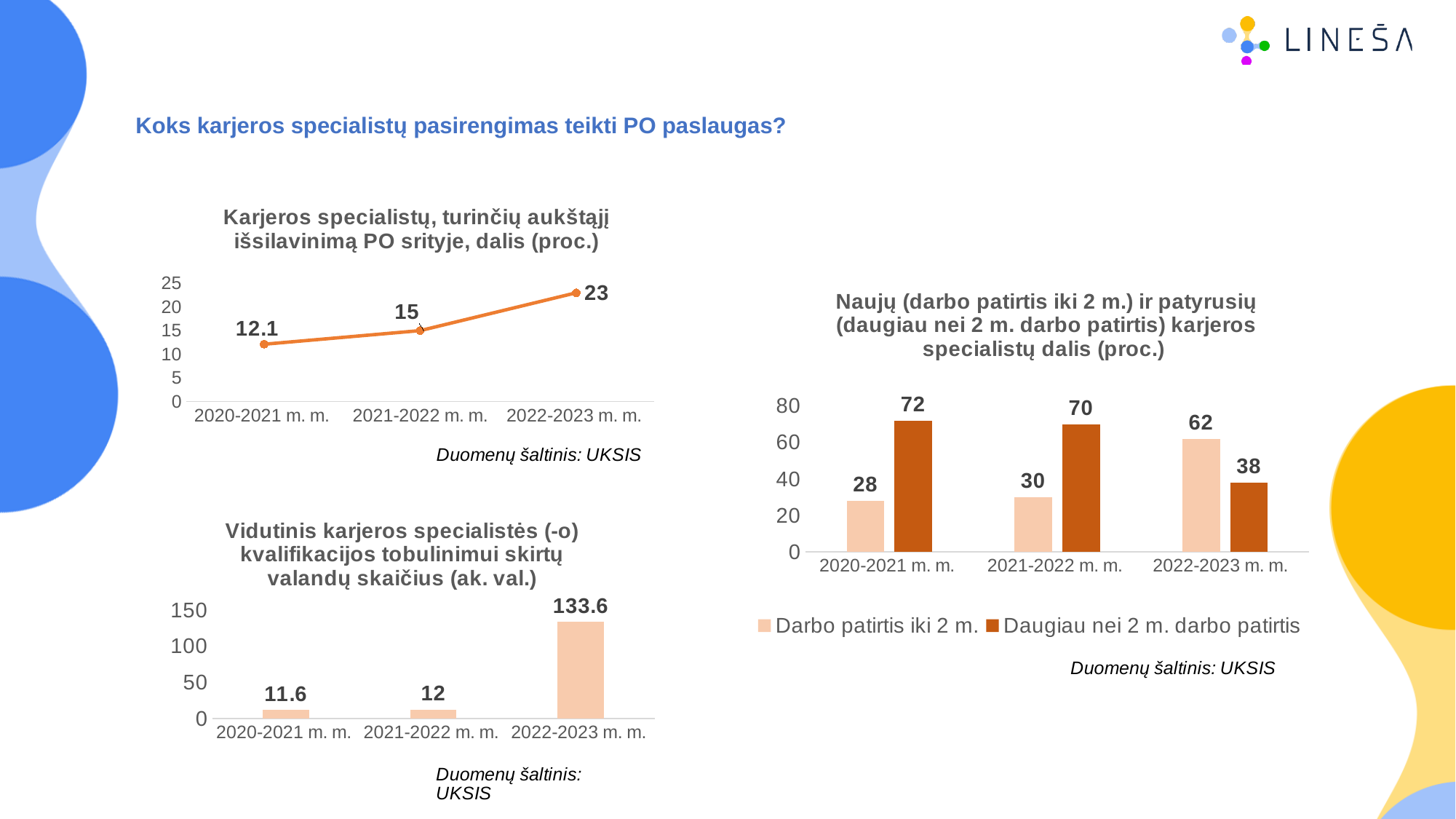
In the bottom-left bar chart (Vidutinis karjeros specialistės (-o) kvalifikacijos tobulinimui skirtų valandų skaičius), which school year has the lowest value? 2020-2021 m. m. In the right-hand bar chart (Naujų ir patyrusių karjeros specialistų dalis), what is the difference between the two series in 2020-2021 m. m.? 44 In the bottom-left bar chart (Vidutinis karjeros specialistės (-o) kvalifikacijos tobulinimui skirtų valandų skaičius), how many categories are shown on the x axis? 3 In the right-hand bar chart (Naujų ir patyrusių karjeros specialistų dalis), what is the value for 'Daugiau nei 2 m. darbo patirtis' in 2021-2022 m. m.? 70 In the top-left line chart (Karjeros specialistų, turinčių aukštąjį išsilavinimą PO srityje), what is the value for 2020-2021 m. m.? 12.1 In the top-left line chart (Karjeros specialistų, turinčių aukštąjį išsilavinimą PO srityje), what is the difference between the 2022-2023 m. m. and 2020-2021 m. m. values? 10.9 In the top-left line chart (Karjeros specialistų, turinčių aukštąjį išsilavinimą PO srityje), do the values rise or fall from 2020-2021 m. m. to 2022-2023 m. m.? rise In the right-hand bar chart (Naujų ir patyrusių karjeros specialistų dalis), how many series does the legend list? 2 In the right-hand bar chart (Naujų ir patyrusių karjeros specialistų dalis), which is larger in 2022-2023 m. m.: 'Darbo patirtis iki 2 m.' or 'Daugiau nei 2 m. darbo patirtis'? Darbo patirtis iki 2 m. In the right-hand bar chart (Naujų ir patyrusių karjeros specialistų dalis), what is the data source stated below the chart? UKSIS In the bottom-left bar chart (Vidutinis karjeros specialistės (-o) kvalifikacijos tobulinimui skirtų valandų skaičius), what is the value for 2022-2023 m. m.? 133.6 In the top-left line chart (Karjeros specialistų, turinčių aukštąjį išsilavinimą PO srityje), what kind of chart is it? line chart